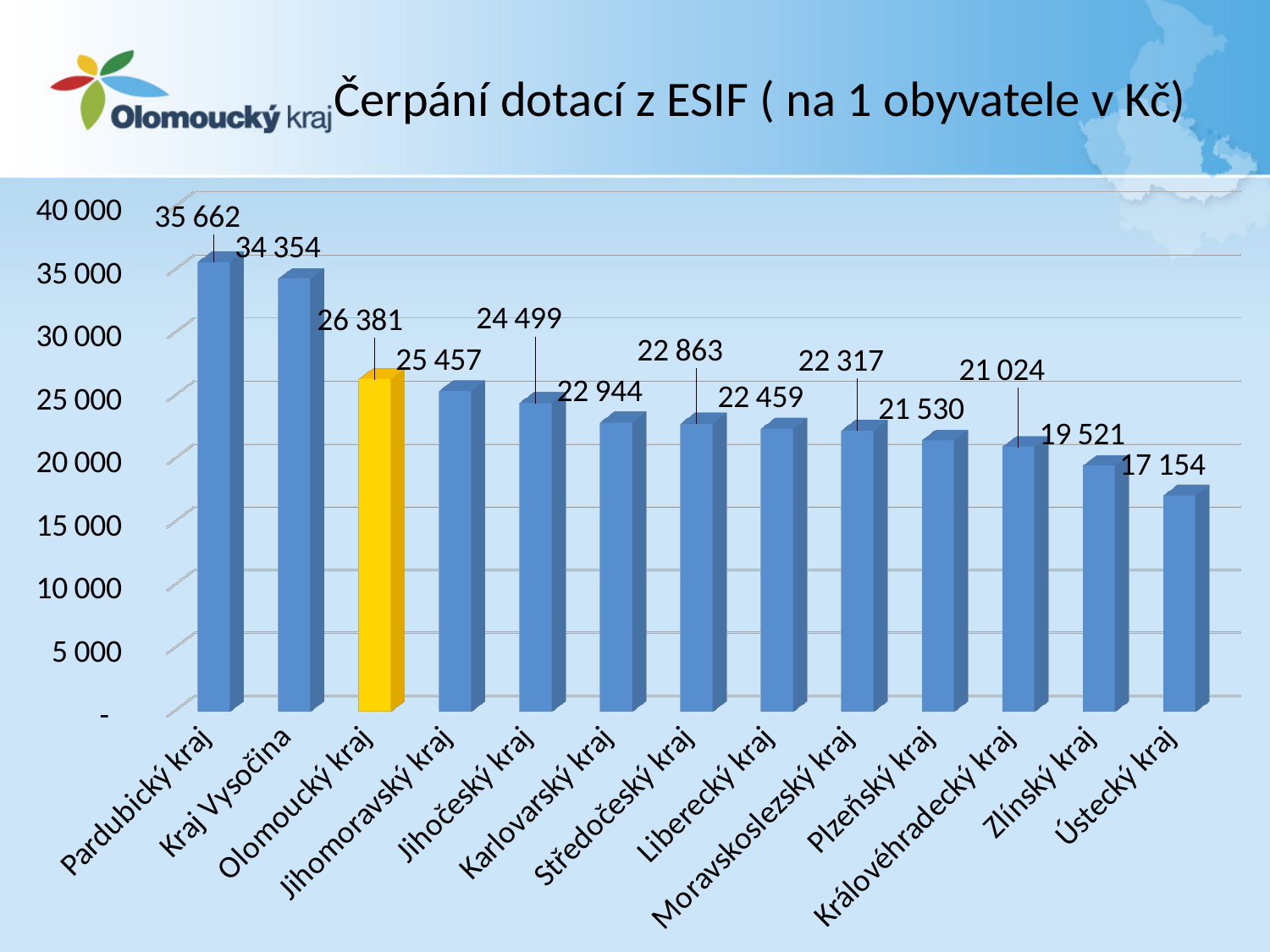
How many regions are shown on the chart? 13 What kind of chart is this? bar chart What is the value for Ústecký kraj? 17 154 What is the value for Olomoucký kraj? 26 381 What is the value for Pardubický kraj? 35 662 What is the difference between Pardubický kraj and Kraj Vysočina? 1 308 Which is larger, the value for Kraj Vysočina or the value for Jihomoravský kraj? Kraj Vysočina Which region has the lowest value? Ústecký kraj What is the value for Jihočeský kraj? 24 499 Which bar is highlighted in yellow? Olomoucký kraj What is the difference between Olomoucký kraj and Ústecký kraj? 9 227 Which region has the highest value? Pardubický kraj